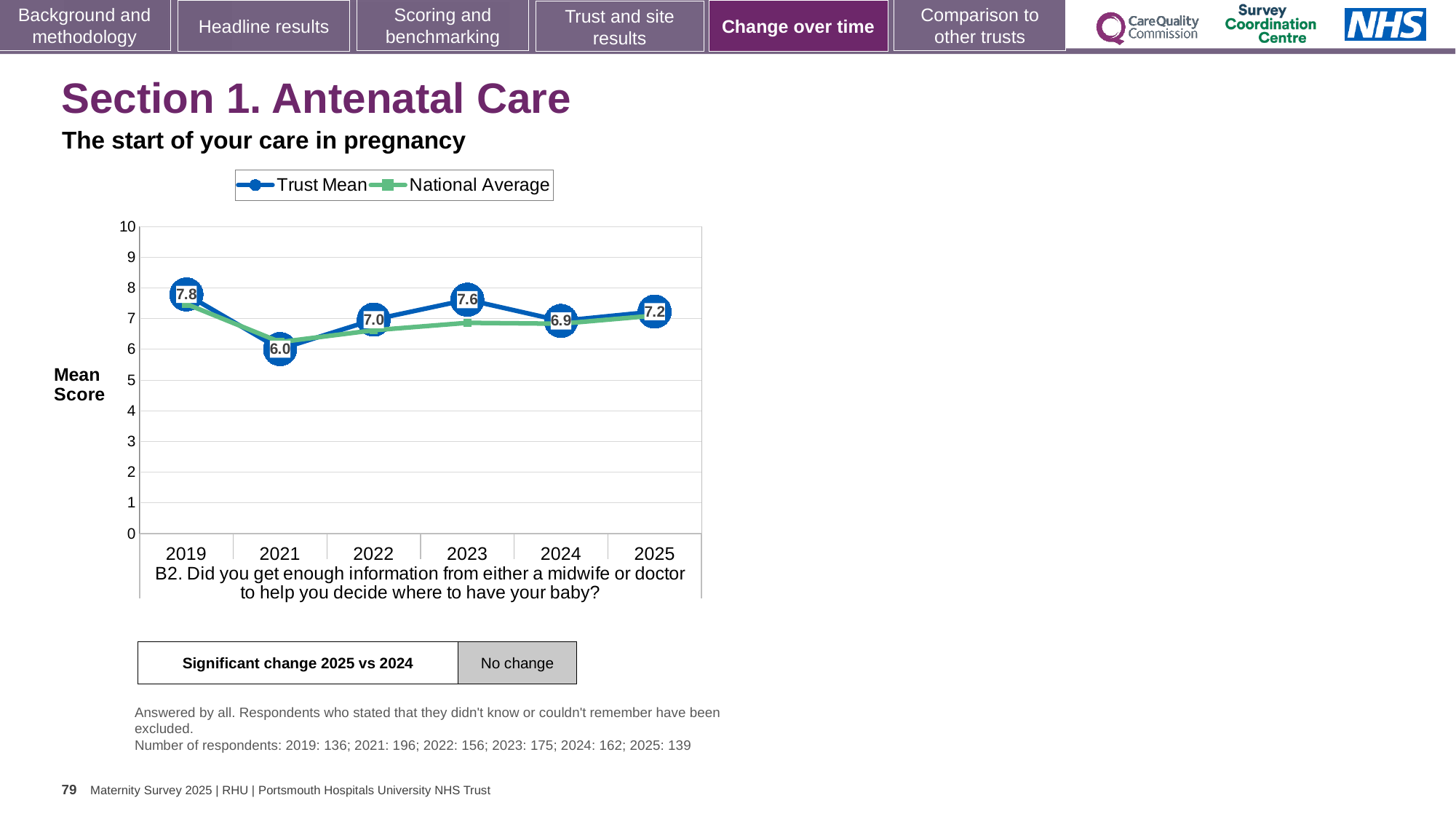
What kind of chart is shown on the slide? Line chart Is the National Average value for 2021 greater or less than 7? less What is the Trust Mean value for 2025? 7.2 How many series does the legend list? 2 How many years are plotted on the x axis? 6 What is the Trust Mean value for 2019? 7.8 Which year has the larger Trust Mean, 2023 or 2024? 2023 What is the difference between the Trust Mean in 2019 and in 2021? 1.8 In which year is the Trust Mean highest? 2019 What is the Trust Mean value for 2024? 6.9 Does the Trust Mean rise or fall from 2021 to 2023? Rise In which year is the Trust Mean lowest? 2021